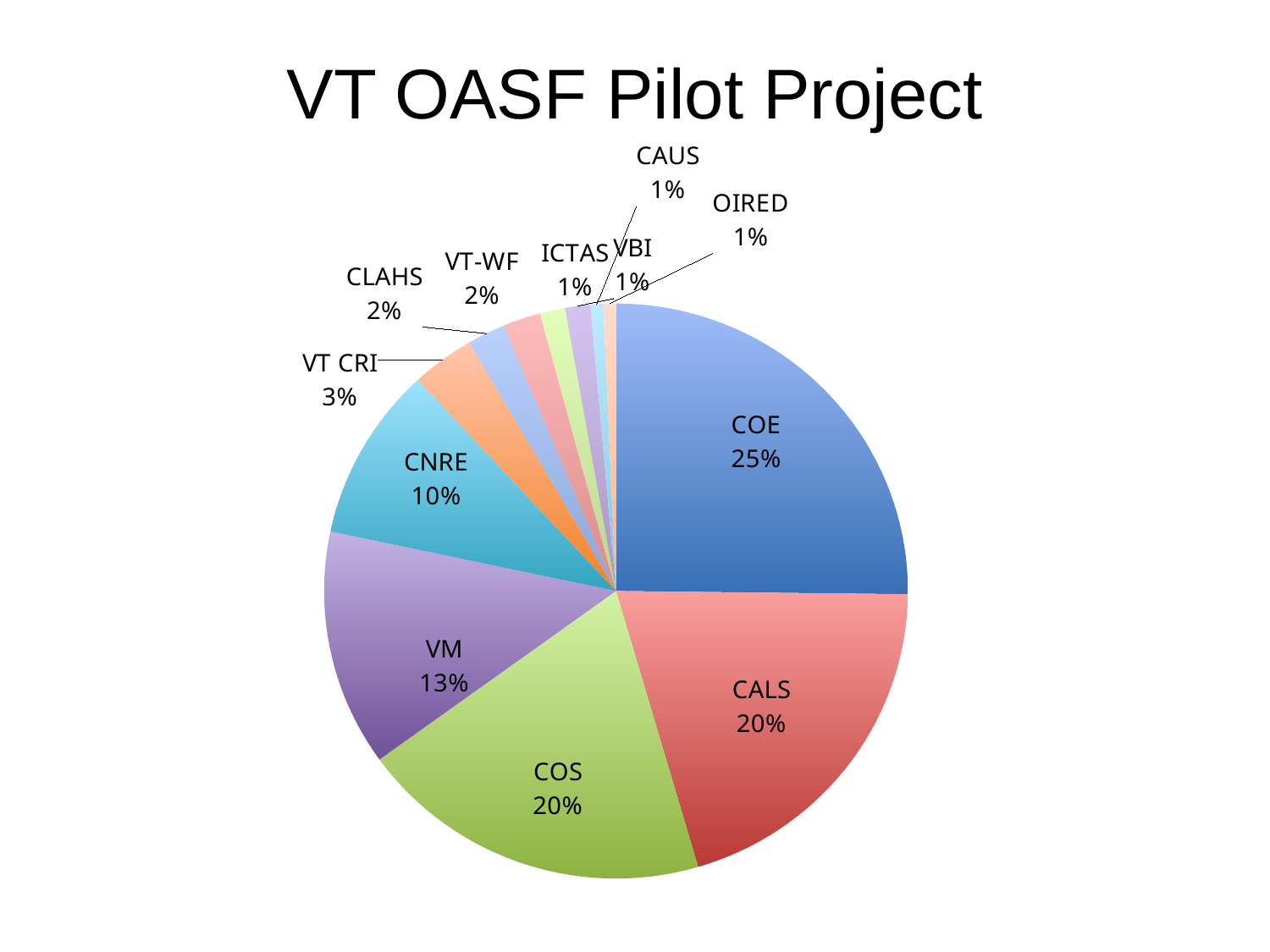
What is the title of the chart? VT OASF Pilot Project What kind of chart is shown on the slide? pie chart Which is larger, the share for VM or the share for CNRE? VM What share of the pie does VM have? 13% What share of the pie does CLAHS have? 2% Which category has the largest slice of the pie? COE How many slices does the pie chart have? 12 What share of the pie does CNRE have? 10% What share of the pie does VT CRI have? 3% What is the difference between the shares of VM and VT CRI? 10% What share of the pie does COE have? 25% What is the difference between the shares of COE and CALS? 5%